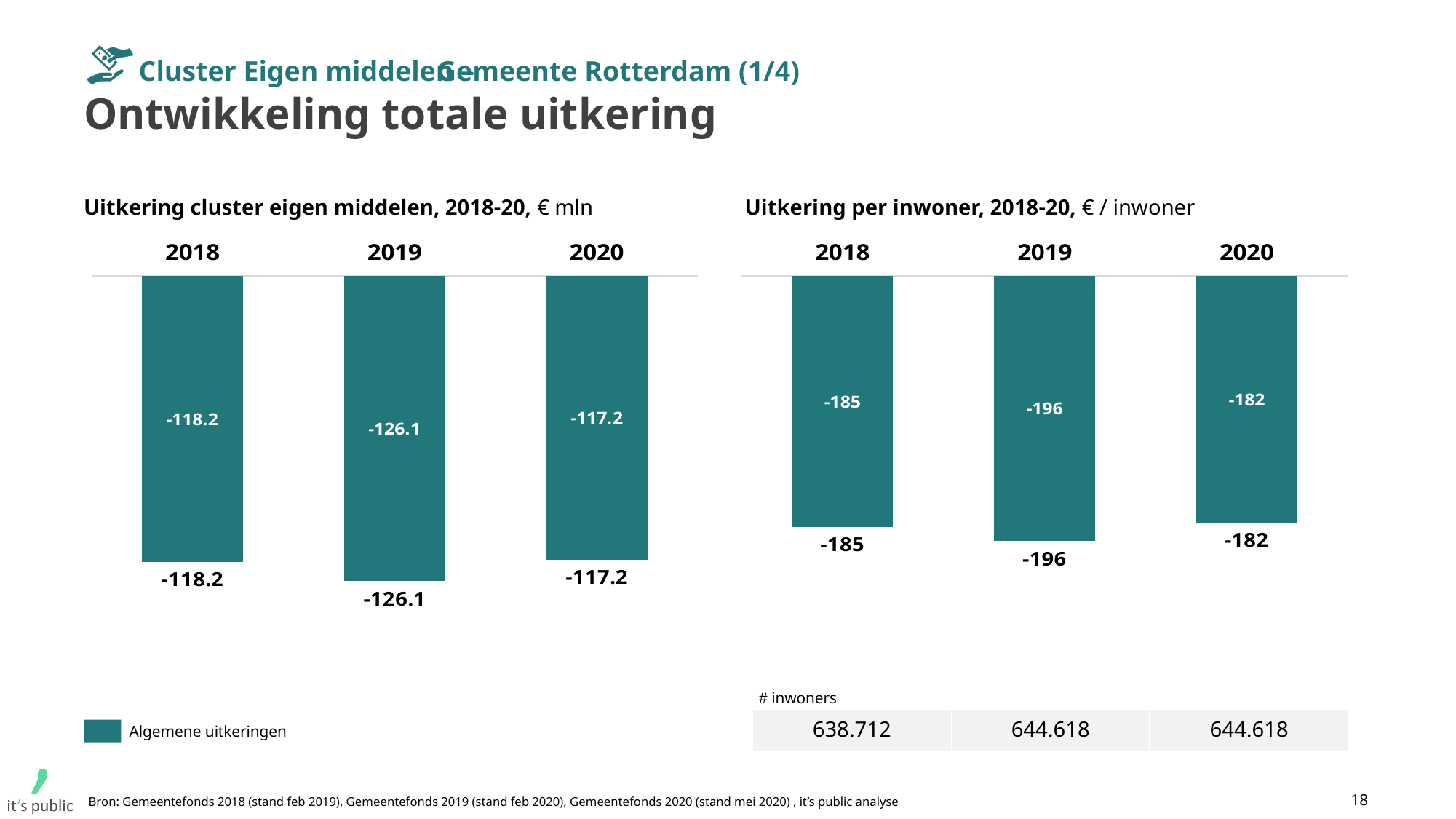
In the chart 'Uitkering per inwoner, 2018-20', what is the value for 2019? -196 What series name does the legend on the slide list? Algemene uitkeringen In the chart 'Uitkering cluster eigen middelen, 2018-20', what is the value for 2019? -126.1 In the chart 'Uitkering per inwoner, 2018-20', what is the difference between the 2019 and 2018 values? 11 In the chart 'Uitkering per inwoner, 2018-20', is the bar for 2019 or 2020 larger in magnitude? 2019 In the chart 'Uitkering per inwoner, 2018-20', what is the value for 2018? -185 What type of chart is 'Uitkering per inwoner, 2018-20'? Bar chart How many years are shown in the chart 'Uitkering cluster eigen middelen, 2018-20'? 3 In the chart 'Uitkering per inwoner, 2018-20', which year has the least negative (highest) value? 2020 In the chart 'Uitkering cluster eigen middelen, 2018-20', by how much does the 2019 value differ from the 2018 value? 7.9 In the chart 'Uitkering cluster eigen middelen, 2018-20', which year has the most negative (lowest) value? 2019 In the chart 'Uitkering cluster eigen middelen, 2018-20', what is the value for 2020? -117.2